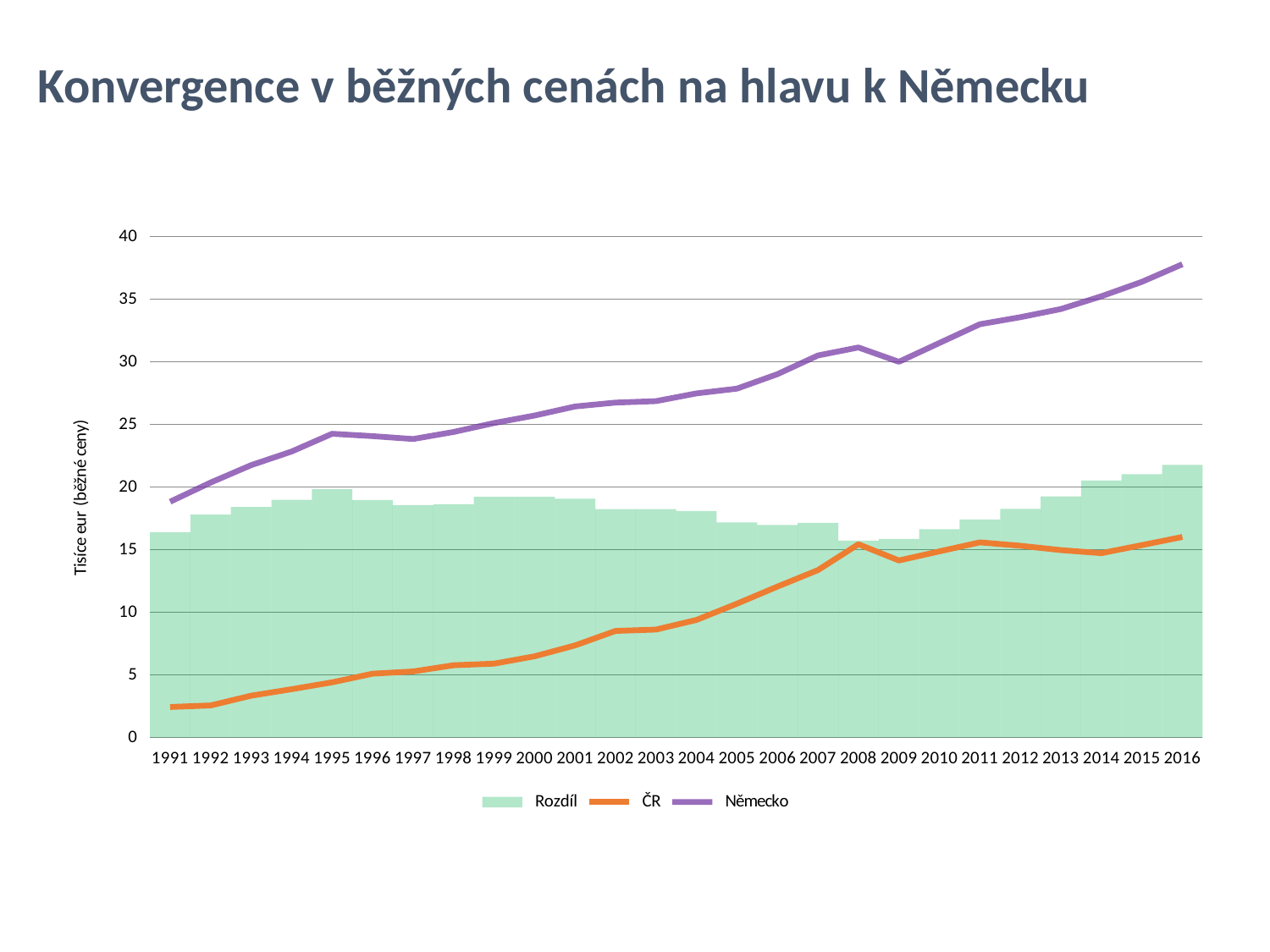
How many years are shown on the x axis? 26 What are the three series named in the legend? Rozdíl, ČR, Německo In which year is the Německo series at its highest? 2016 Is the value for Německo in 2016 greater or less than 35? greater What is the title of the vertical axis? Tisíce eur (běžné ceny) Is the value for ČR in 1991 greater or less than 5? less Which series has the larger value in 2016, ČR or Německo? Německo Is the value for Německo in 1991 greater or less than 20? less How many series does the legend list? 3 In which year is the ČR series at its lowest? 1991